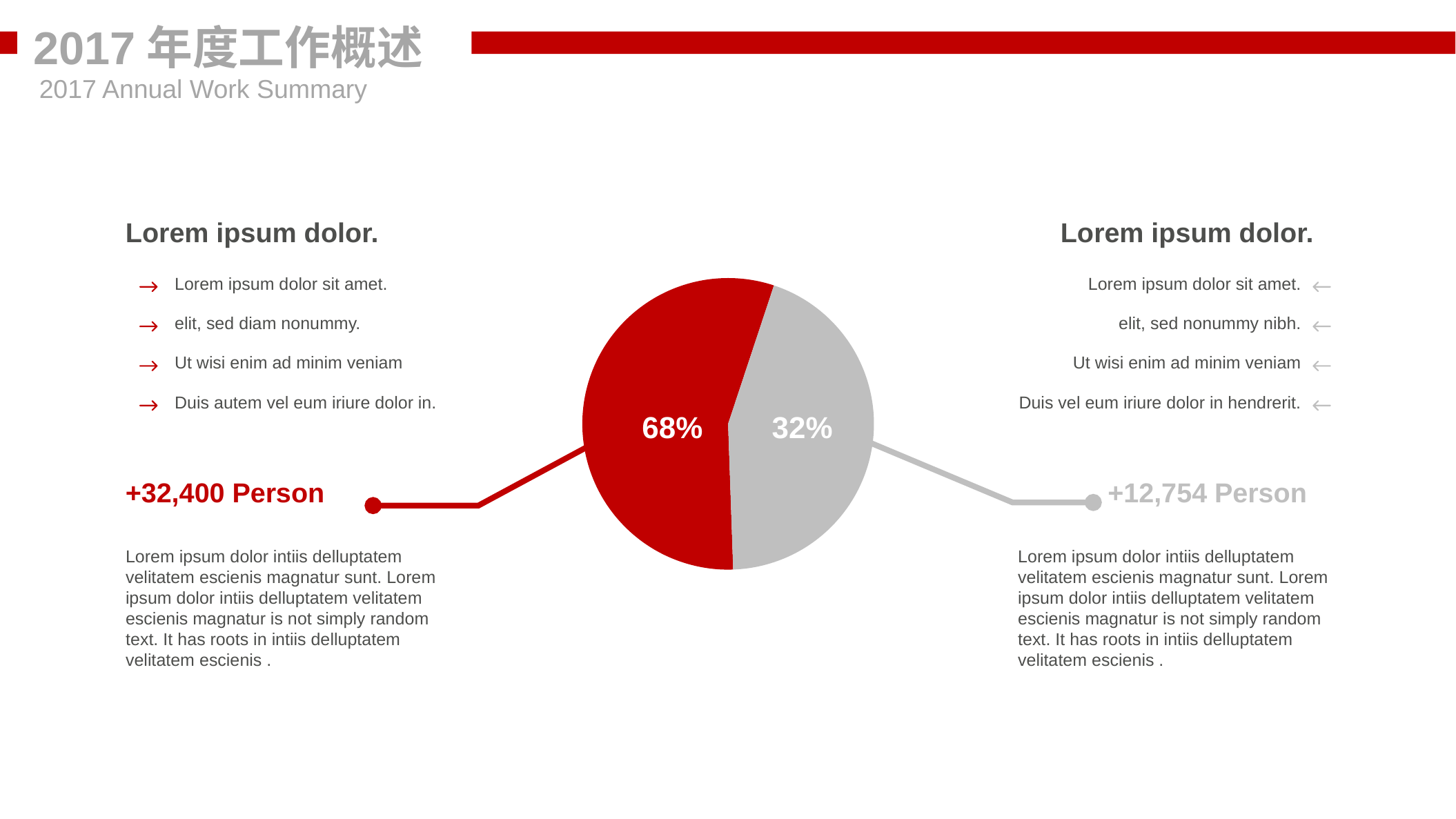
What is the difference in percentage points between the red slice and the grey slice? 36 What kind of chart is shown on the slide? pie chart Which is larger, the red slice or the grey slice of the pie chart? the red slice Which slice of the pie chart is the smallest? the grey slice (32%) What percentage is shown on the red slice of the pie chart? 68% What share of the pie does the red slice represent? 68% What percentage is shown on the grey slice of the pie chart? 32% How many slices does the pie chart have? 2 What figure is connected to the grey slice of the pie chart by the callout line? +12,754 Person What is the total of the two percentages shown on the pie chart? 100% What figure is connected to the red slice of the pie chart by the callout line? +32,400 Person Which slice of the pie chart is the largest? the red slice (68%)